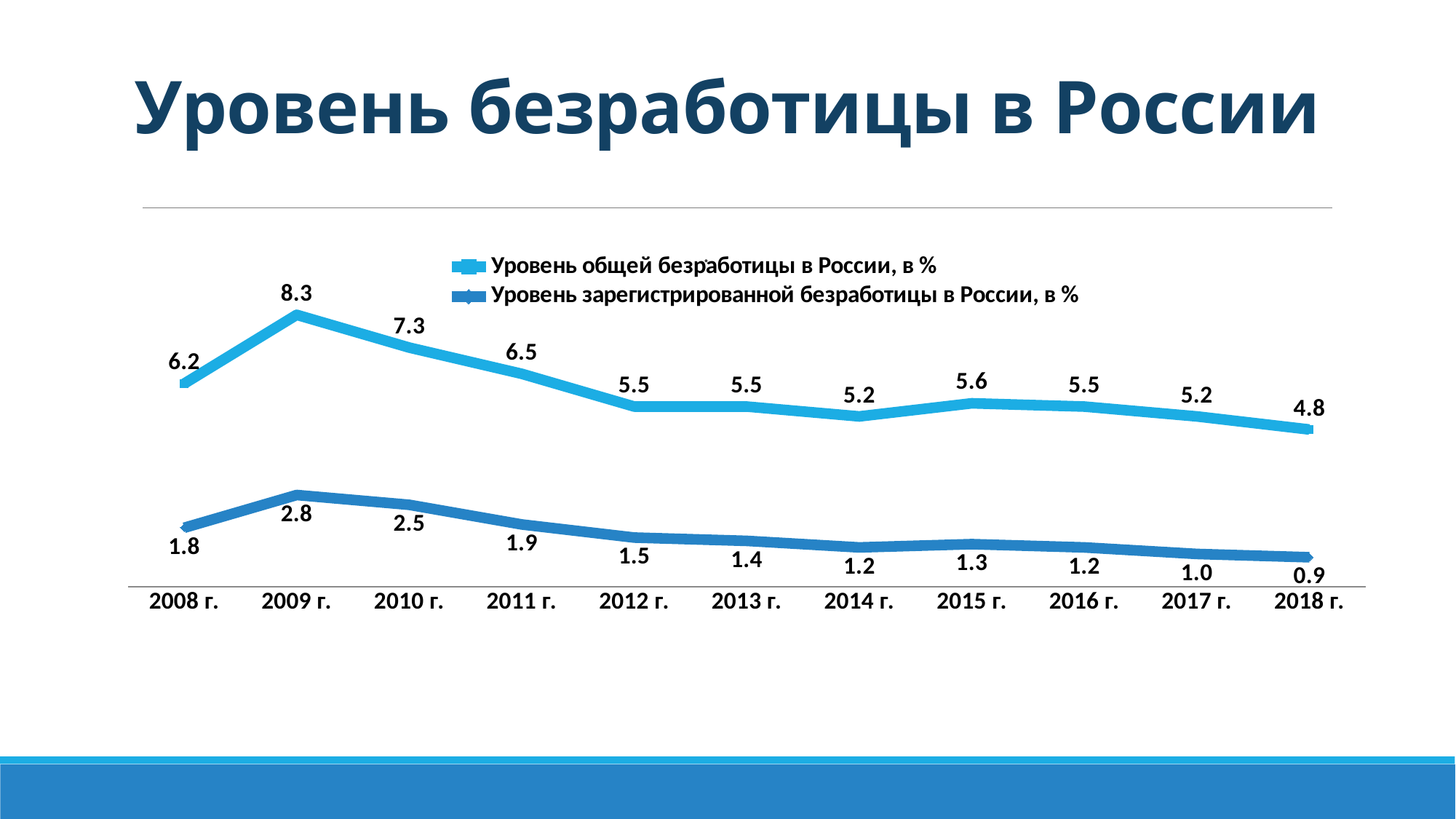
What type of chart is shown on the slide? line chart Does the registered unemployment rate generally rise or fall from 2009 г. to 2018 г.? fall What is the value of 'Уровень общей безработицы в России, в %' for 2009 г.? 8.3 Which is larger: the general unemployment rate in 2010 г. or in 2011 г.? 2010 г. What is the title of the chart on the slide? Уровень безработицы в России How many years are plotted along the x axis? 11 In which year is 'Уровень зарегистрированной безработицы в России, в %' lowest? 2018 г. What is the difference between the general unemployment rate and the registered unemployment rate in 2008 г.? 4.4 What is the value of 'Уровень зарегистрированной безработицы в России, в %' for 2018 г.? 0.9 What is the difference between the general unemployment rate in 2009 г. and in 2018 г.? 3.5 How many series does the legend list? 2 In which year is 'Уровень общей безработицы в России, в %' highest? 2009 г.